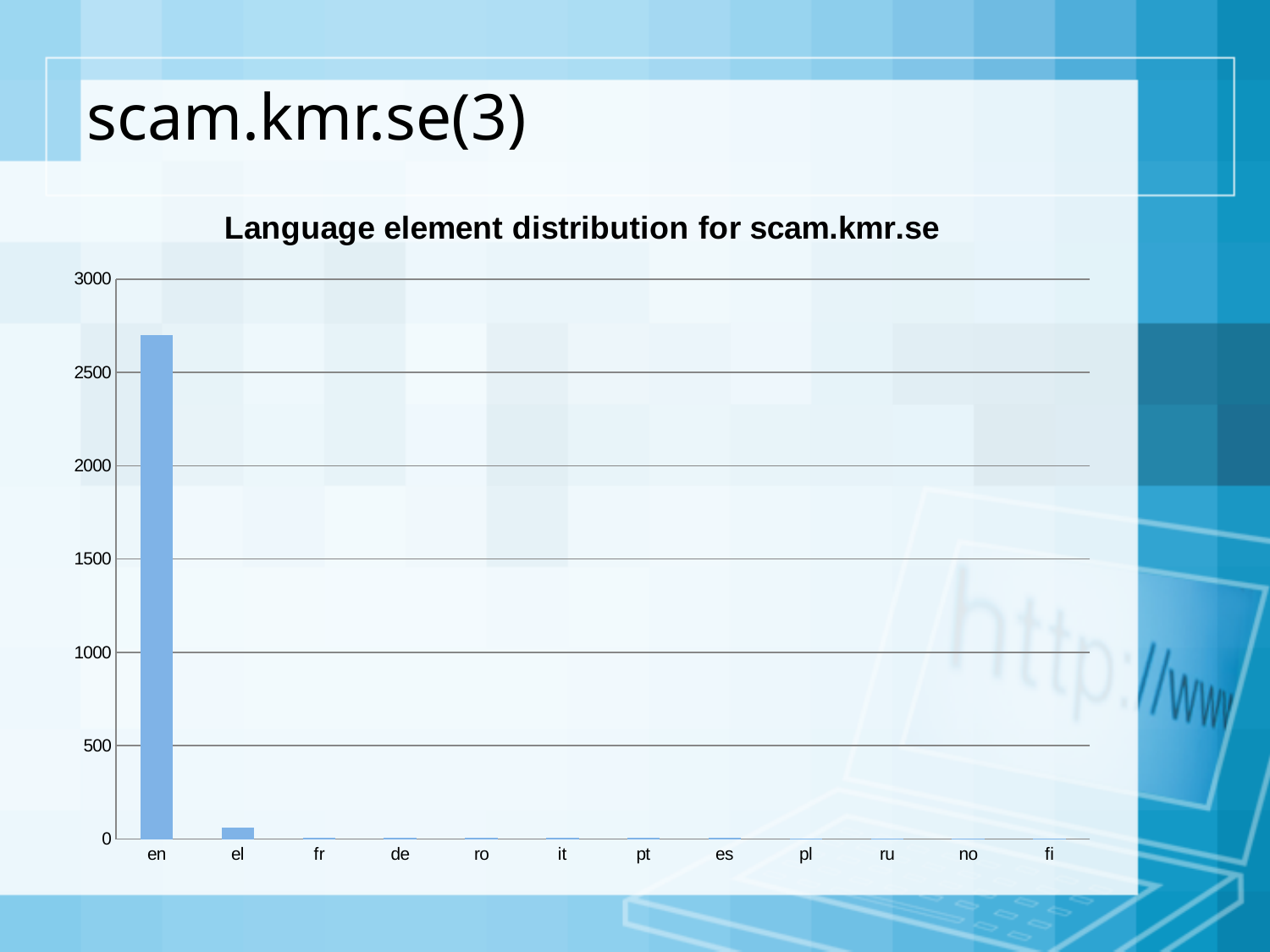
Is the value for en greater or less than 3000? less Do the values generally rise or fall moving from left to right along the x axis? fall Which language has the highest value? en Which language is the first category on the x axis? en Which is larger, the value for en or the value for el? en How many language categories are shown on the x axis? 12 What kind of chart is shown on the slide? bar chart Is the value for el greater or less than 500? less What is the title of the chart? Language element distribution for scam.kmr.se Which is larger, the value for el or the value for fr? el Is the value for en greater or less than 2500? greater What is the highest value shown on the y axis? 3000